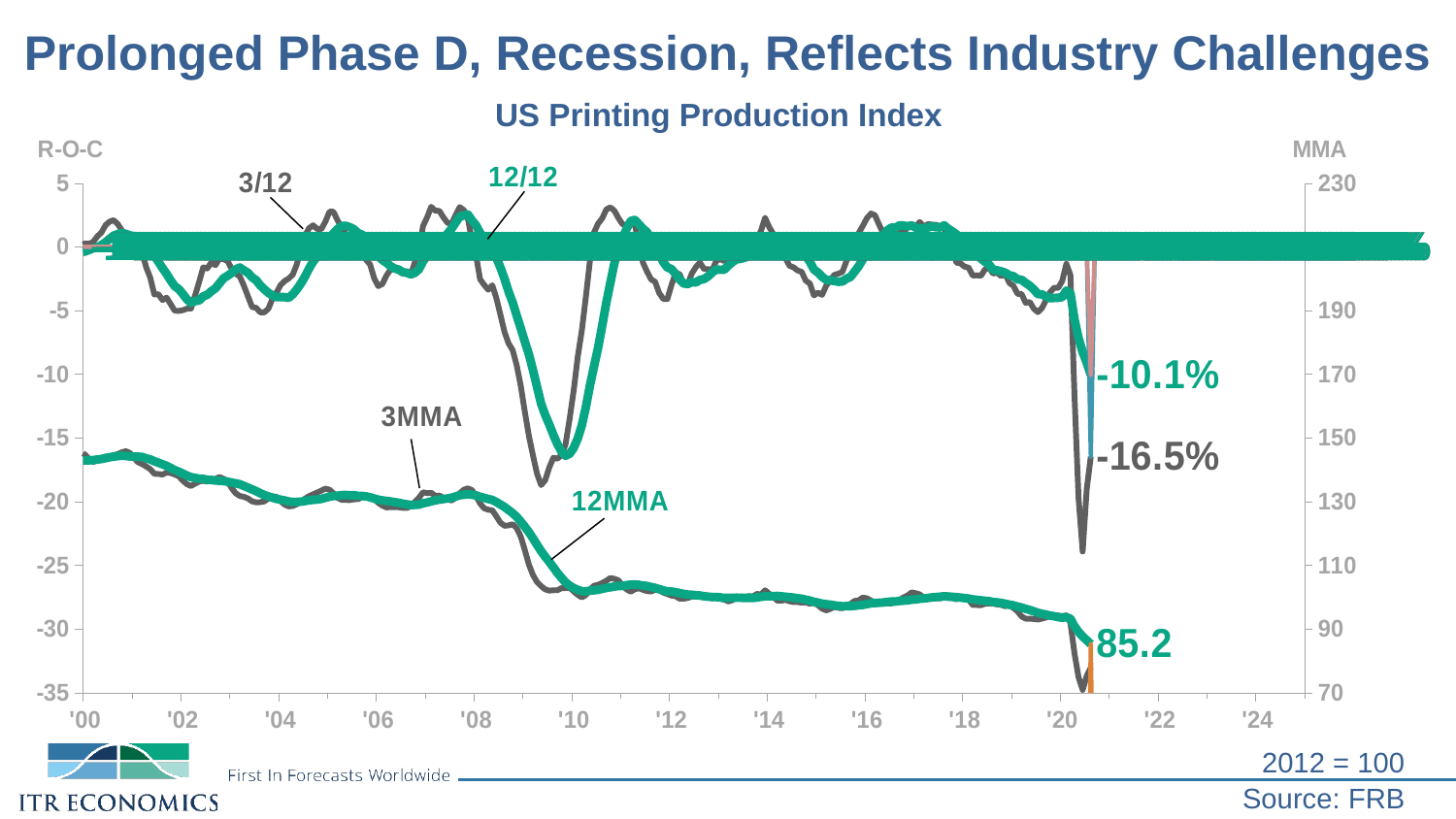
How many lines are plotted on the chart? 4 Which is lower at the latest labeled point, the 3/12 value or the 12/12 value? 3/12 What is the latest labeled value of the 3/12 rate-of-change line? -16.5% What is the latest labeled value of the 12MMA line? 85.2 What type of chart is shown on the slide? line chart What is the base year noted for the index (index = 100)? 2012 What is the title of the chart? US Printing Production Index What is the latest labeled value of the 12/12 rate-of-change line? -10.1% What is the difference between the latest labeled 12/12 value (-10.1%) and the latest labeled 3/12 value (-16.5%)? 6.4 percentage points Is the latest labeled 12MMA value greater or less than 90 on the MMA axis? less What is the overall trend of the 12MMA line from '00 to '20? falling What is the highest value shown on the right-hand MMA axis? 230